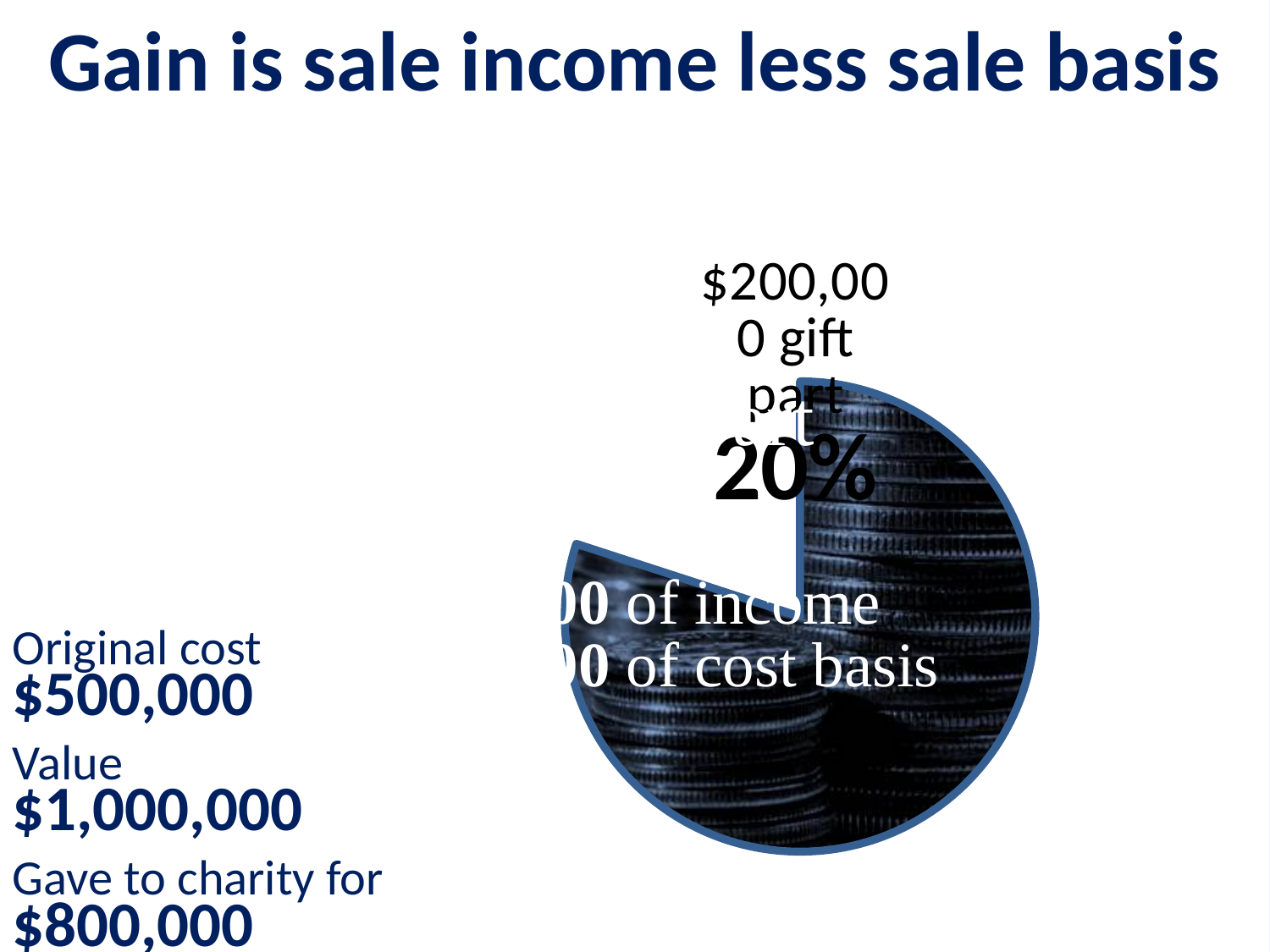
What image fills the larger slice of the pie chart? stacked coins Is the gift part slice of the pie chart greater or less than 50%? less What percentage of the pie does the gift part slice represent? 20% How many slices does the pie chart have? 2 What kind of chart is shown on the slide? pie chart What dollar amount is labeled on the gift part slice of the pie chart? $200,000 Which slice of the pie chart is larger, the gift part slice or the remaining slice? the remaining slice What is the title of the slide containing the pie chart? Gain is sale income less sale basis